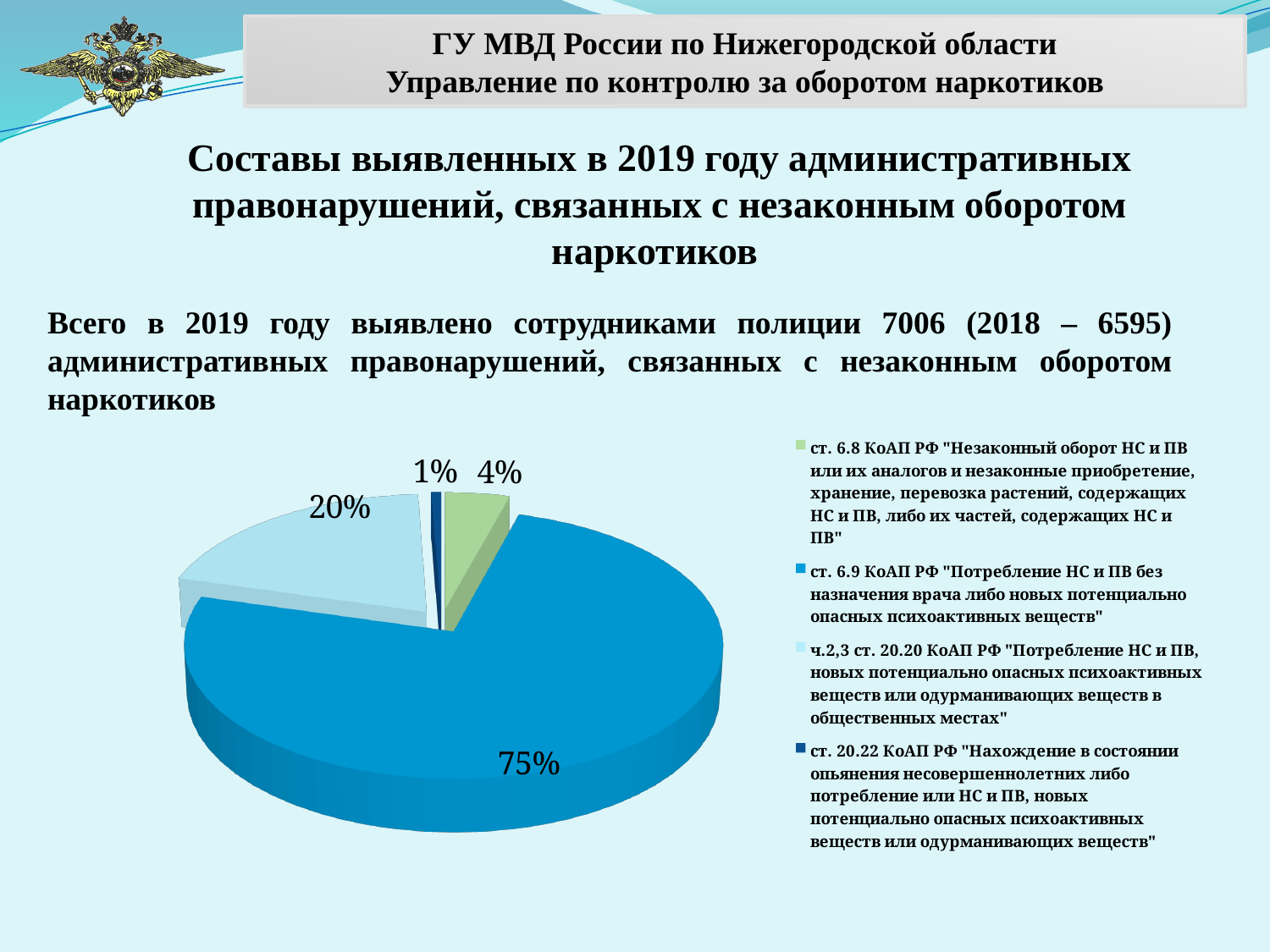
What share of the pie does ст. 20.22 КоАП РФ account for? 1% What share of the pie does ст. 6.8 КоАП РФ account for? 4% What share of the pie does ч.2,3 ст. 20.20 КоАП РФ account for? 20% How many slices does the pie chart have? 4 What colour is the slice representing ст. 6.8 КоАП РФ in the pie chart? Green How many entries does the legend of the pie chart list? 4 What is the difference in percentage points between the slice for ст. 6.9 КоАП РФ and the slice for ч.2,3 ст. 20.20 КоАП РФ? 55 percentage points Which legend category has the largest slice of the pie? ст. 6.9 КоАП РФ "Потребление НС и ПВ без назначения врача либо новых потенциально опасных психоактивных веществ" Which slice is larger: ст. 6.8 КоАП РФ or ч.2,3 ст. 20.20 КоАП РФ? ч.2,3 ст. 20.20 КоАП РФ What kind of chart is shown on the slide? Pie chart Which legend category has the smallest slice of the pie? ст. 20.22 КоАП РФ "Нахождение в состоянии опьянения несовершеннолетних..."